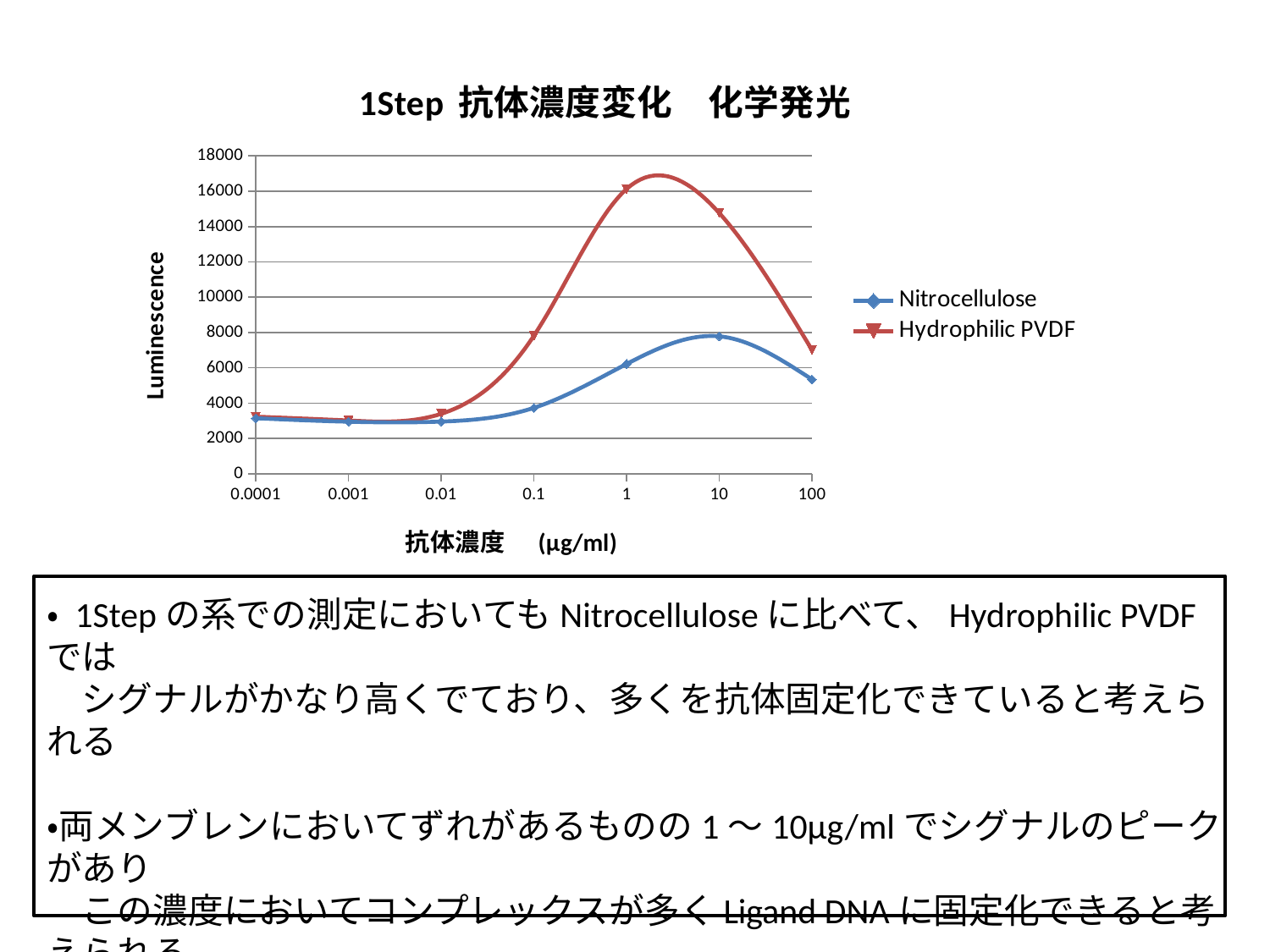
At which antibody concentration does the Hydrophilic PVDF series reach its highest luminescence? 1 What kind of chart is shown on the slide? line chart At which antibody concentration does the Nitrocellulose series reach its highest luminescence? 10 What is the title of the vertical axis? Luminescence Is the Nitrocellulose value at 100 µg/ml greater or less than 6000? less Is the Hydrophilic PVDF value at 1 µg/ml greater or less than 14000? greater Does the Hydrophilic PVDF series rise or fall between 10 and 100 µg/ml? fall How many data points are plotted for the Nitrocellulose series? 7 How many series does the legend list? 2 At 1 µg/ml, which series has the higher luminescence, Nitrocellulose or Hydrophilic PVDF? Hydrophilic PVDF Is the Nitrocellulose value at 10 µg/ml greater or less than 6000? greater